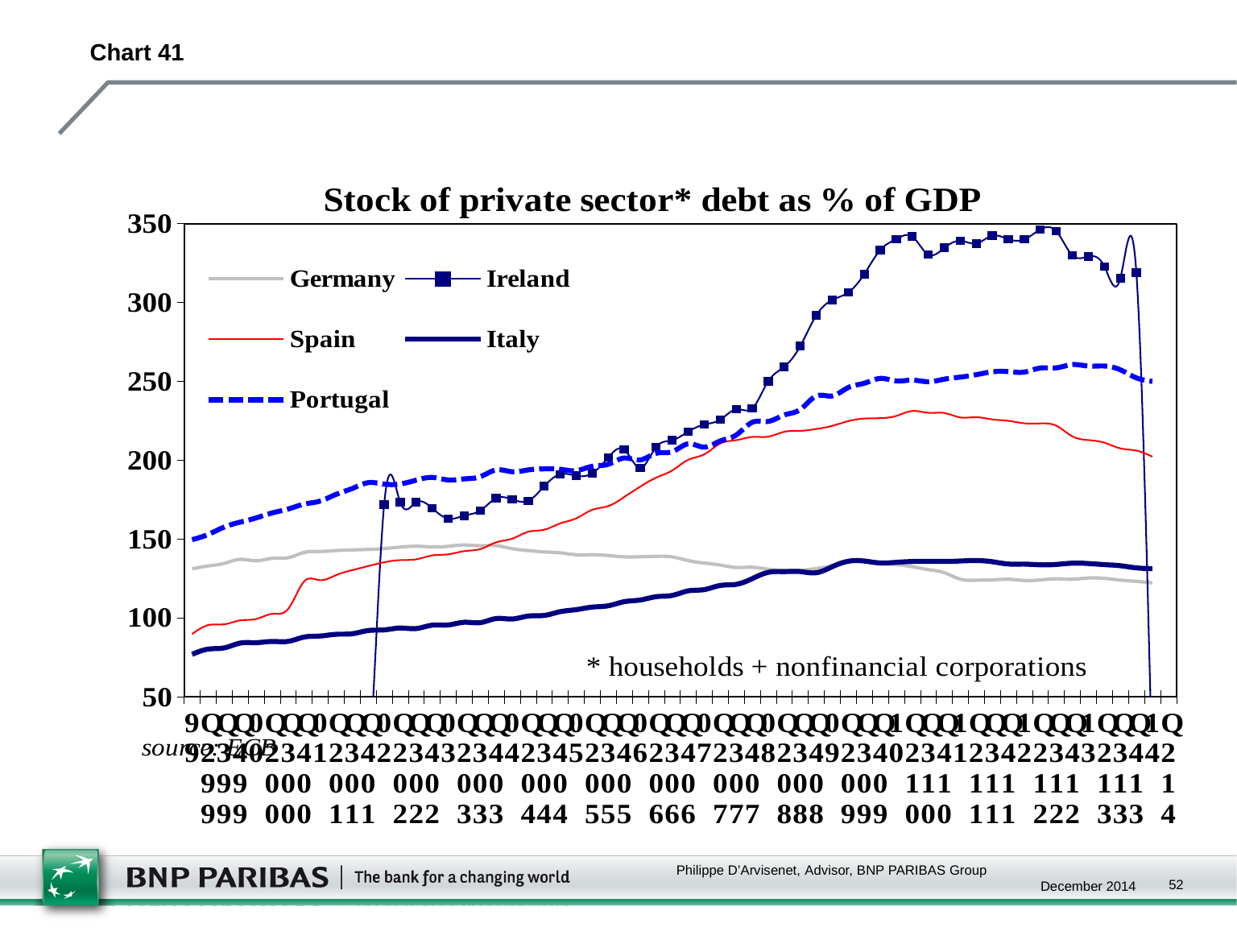
What is the title of the chart? Stock of private sector* debt as % of GDP Which series is drawn as a thick dashed line? Portugal Does the Italy series generally rise or fall over the period? rise How many series does the legend list? 5 Is the peak value for Ireland greater or less than 300? greater At the end of the period, which is higher, Portugal or Spain? Portugal Is the peak value for Spain greater or less than 200? greater What kind of chart is shown on the slide? line chart Is the highest value reached by Germany greater or less than 150? less Which series has the lowest value at the start of the period? Italy Which series reaches the highest value on the chart? Ireland